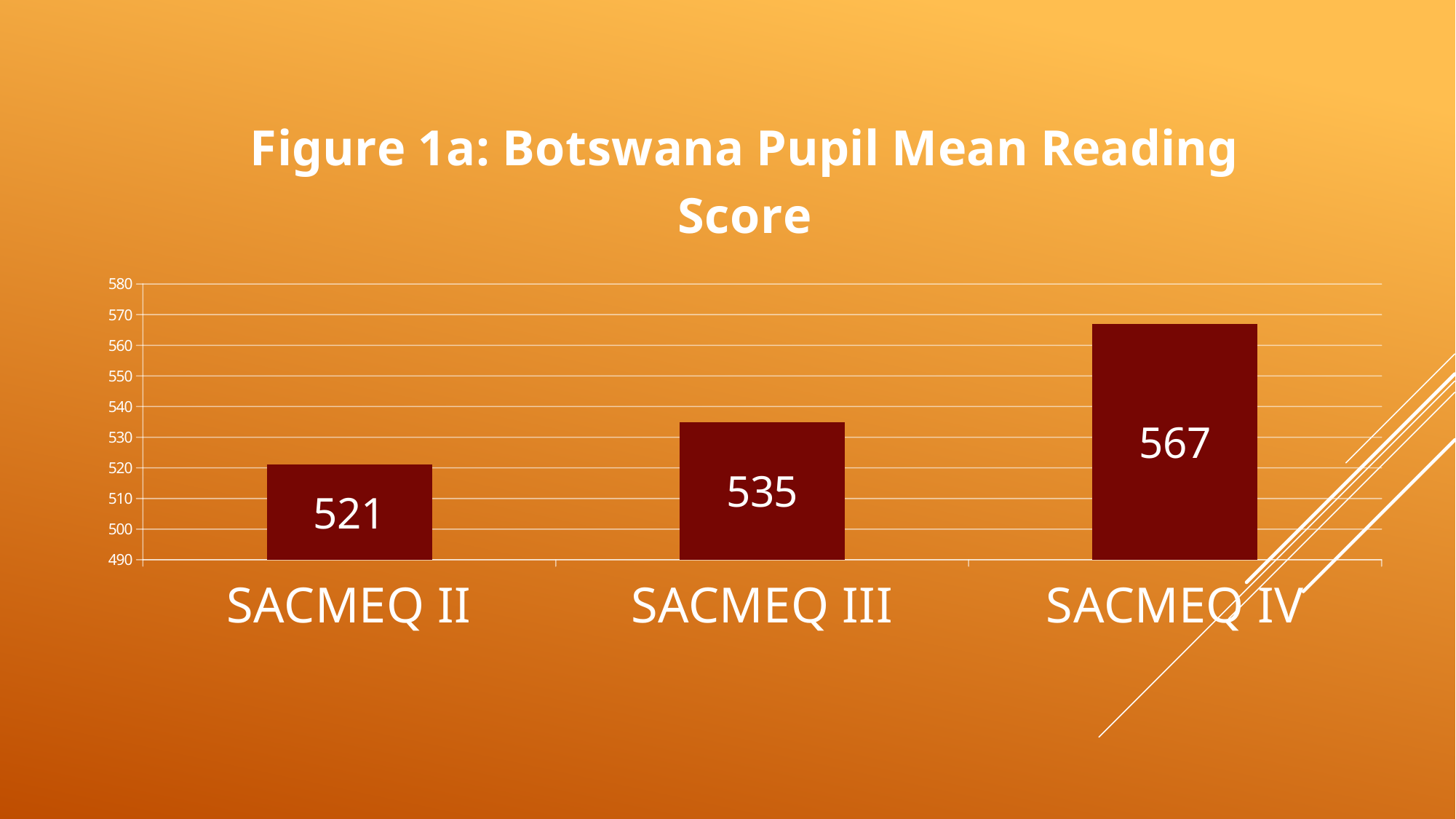
What is the mean reading score for SACMEQ III? 535 How many SACMEQ rounds are shown on the chart? 3 Is the value for SACMEQ III greater or less than 540? less What kind of chart is shown on the slide? Bar chart Do the mean reading scores rise or fall from SACMEQ II to SACMEQ IV? Rise What is the mean reading score for SACMEQ II? 521 Which is larger, the mean reading score for SACMEQ III or for SACMEQ IV? SACMEQ IV What is the difference between the SACMEQ III and SACMEQ II mean reading scores? 14 What is the difference between the SACMEQ IV and SACMEQ II mean reading scores? 46 What is the mean reading score for SACMEQ IV? 567 Which SACMEQ round has the lowest mean reading score? SACMEQ II Which SACMEQ round has the highest mean reading score? SACMEQ IV